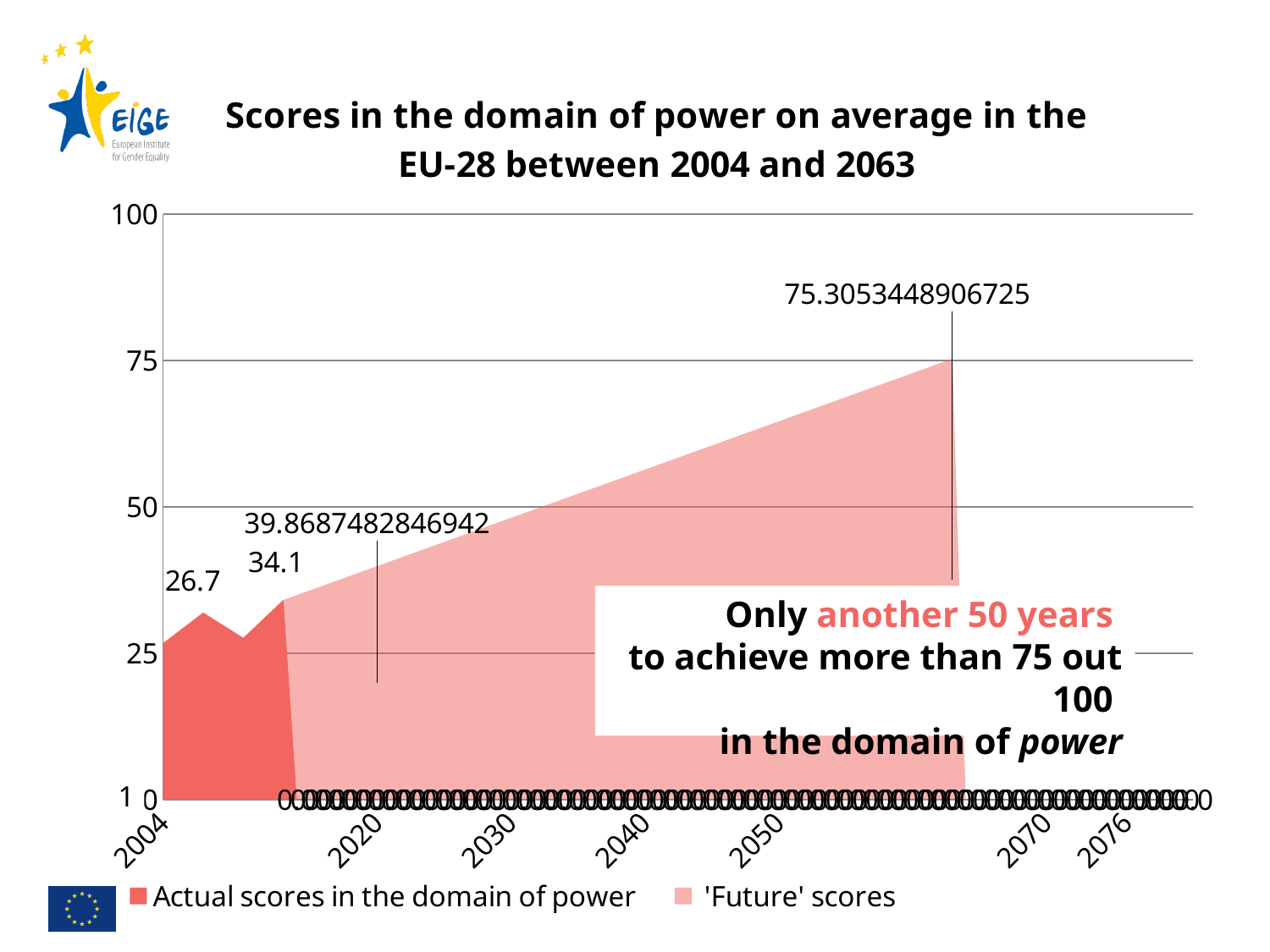
Which is larger: the labelled value 34.1 or the labelled value 39.8687482846942? 39.8687482846942 What is the data label shown for the 'Future' scores at 2020? 39.8687482846942 How many series does the legend list? 2 What kind of chart is shown on the slide? Area chart What are the two legend entries of the chart? Actual scores in the domain of power; 'Future' scores What is the data label shown at the start of the chart, in 2004? 26.7 What is the title of the chart? Scores in the domain of power on average in the EU-28 between 2004 and 2063 Is the 'Future' score at 2040 greater or less than 50? greater Do the 'Future' scores rise or fall from 2020 onwards along the x axis? Rise What is the highest data label shown on the chart? 75.3053448906725 What is the difference between the labelled values 34.1 and 26.7? 7.4